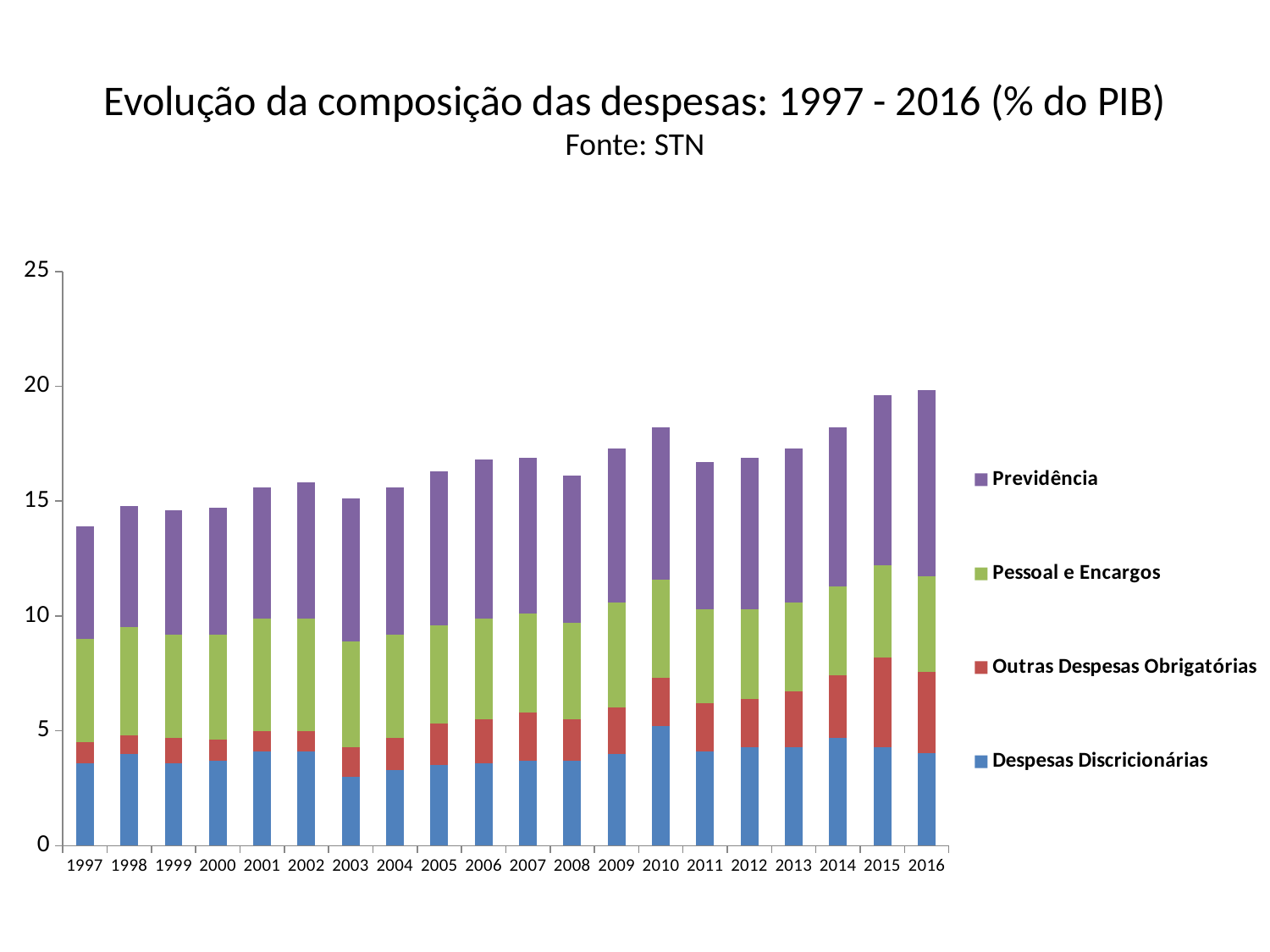
Which year has the larger total stacked bar, 2010 or 2011? 2010 Do the total stacked values generally rise or fall from 1997 to 2016? rise Is the total stacked value for 2016 greater or less than 15? greater Which series is shown at the top of each stacked bar? Previdência Is the total stacked value for 2015 greater or less than 20? less What kind of chart is shown on the slide? Stacked bar chart How many years are shown along the x axis? 20 Which year has the larger total stacked bar, 2008 or 2009? 2009 Is the total stacked value for 1997 greater or less than 15? less Which year has the lowest total stacked bar? 1997 How many series does the legend list? 4 What source is cited below the chart title? STN